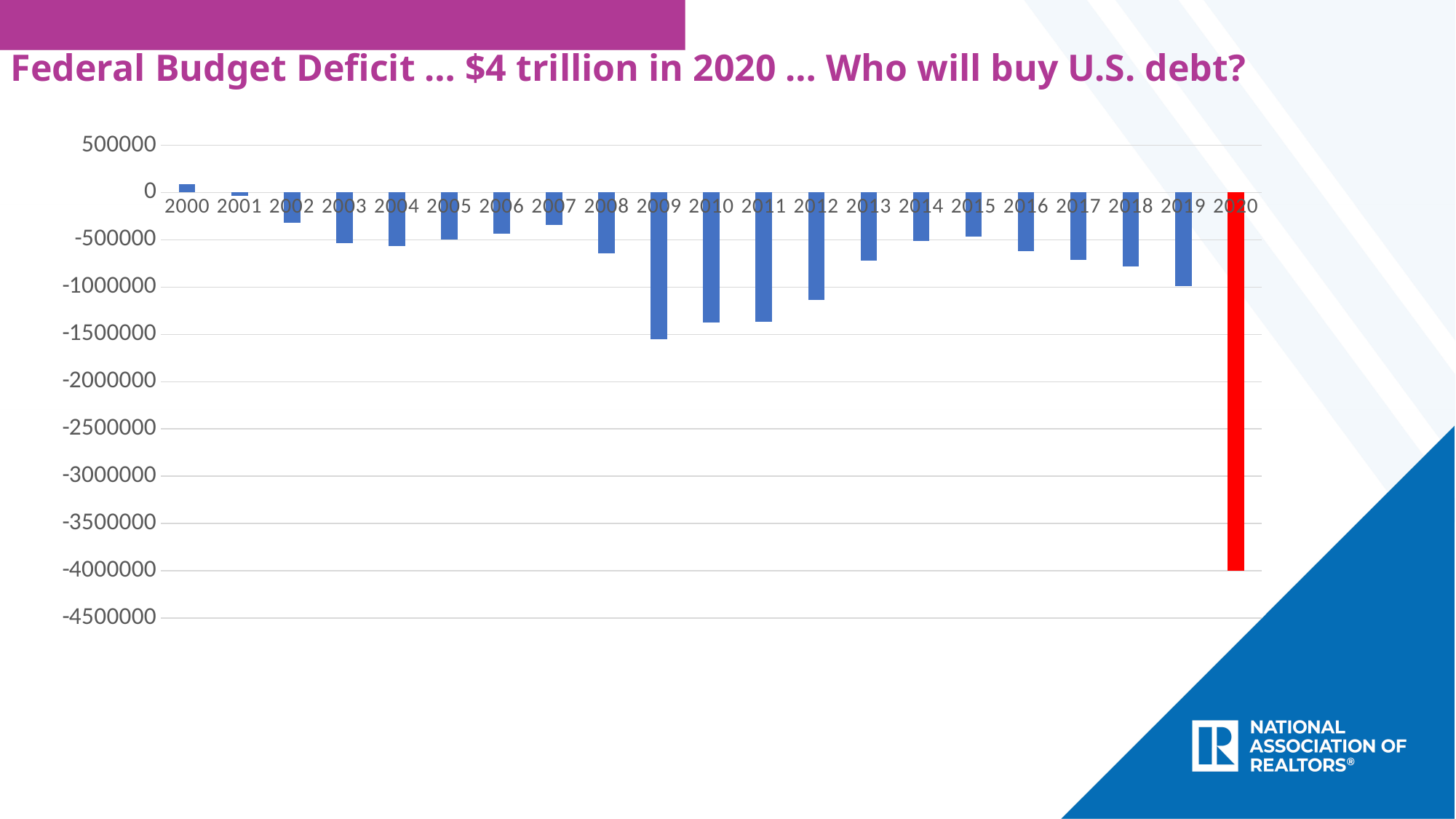
Is the value for 2019 greater or less than -500000? less Which year has the lowest value on the chart? 2020 What kind of chart is shown on the slide? bar chart Which year has the highest value on the chart? 2000 How many years are plotted on the x axis of the chart? 21 Do the values rise or fall from 2015 to 2019? fall What is the value plotted for 2020? -4000000 Is the value for 2001 greater or less than -500000? greater Which year has the larger value, 2008 or 2009? 2008 Is the value for 2013 greater or less than -1000000? greater What colour is the bar for 2020? red